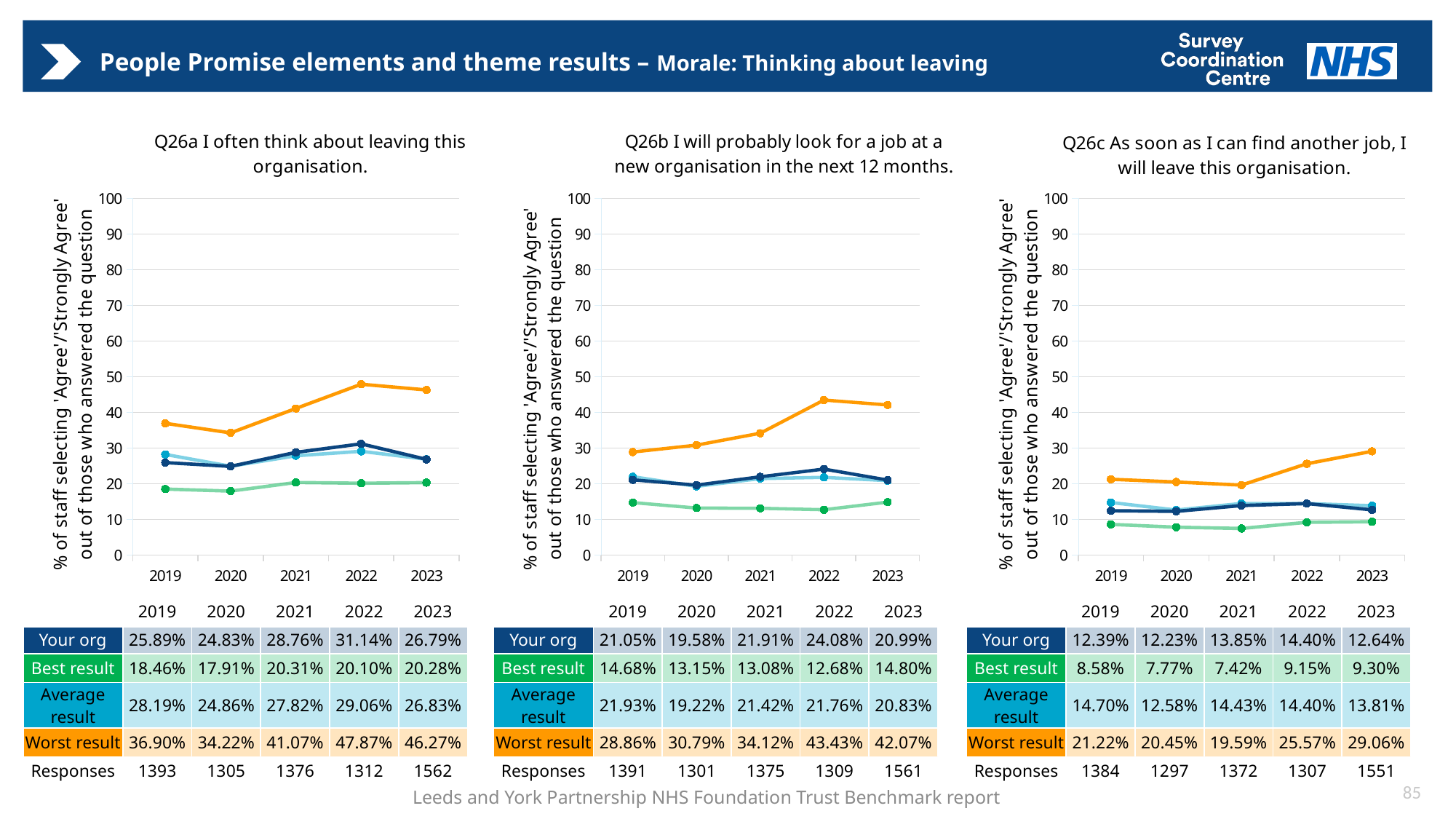
In the Q26c chart, what is the 'Best result' value for 2021? 7.42% In the Q26b chart, is the 'Worst result' value for 2022 greater or less than 40? greater In the Q26a chart, what is the 'Your org' value for 2022? 31.14% In the Q26b chart, how many responses were recorded for 2023? 1561 In the Q26c chart, what is the difference between the 'Worst result' and 'Your org' values for 2023? 16.42% In the Q26c chart, does the 'Worst result' line rise or fall from 2021 to 2023? Rise How many years are plotted on the x axis of the Q26c chart? 5 In the Q26a chart, which is larger for 2019: 'Your org' or 'Average result'? Average result In the Q26b chart, which year has the lowest 'Best result' value? 2022 In the Q26a chart, which year has the highest 'Worst result' value? 2022 In the Q26b chart, what is the 'Worst result' value for 2023? 42.07% What type of chart is used for Q26a? Line chart